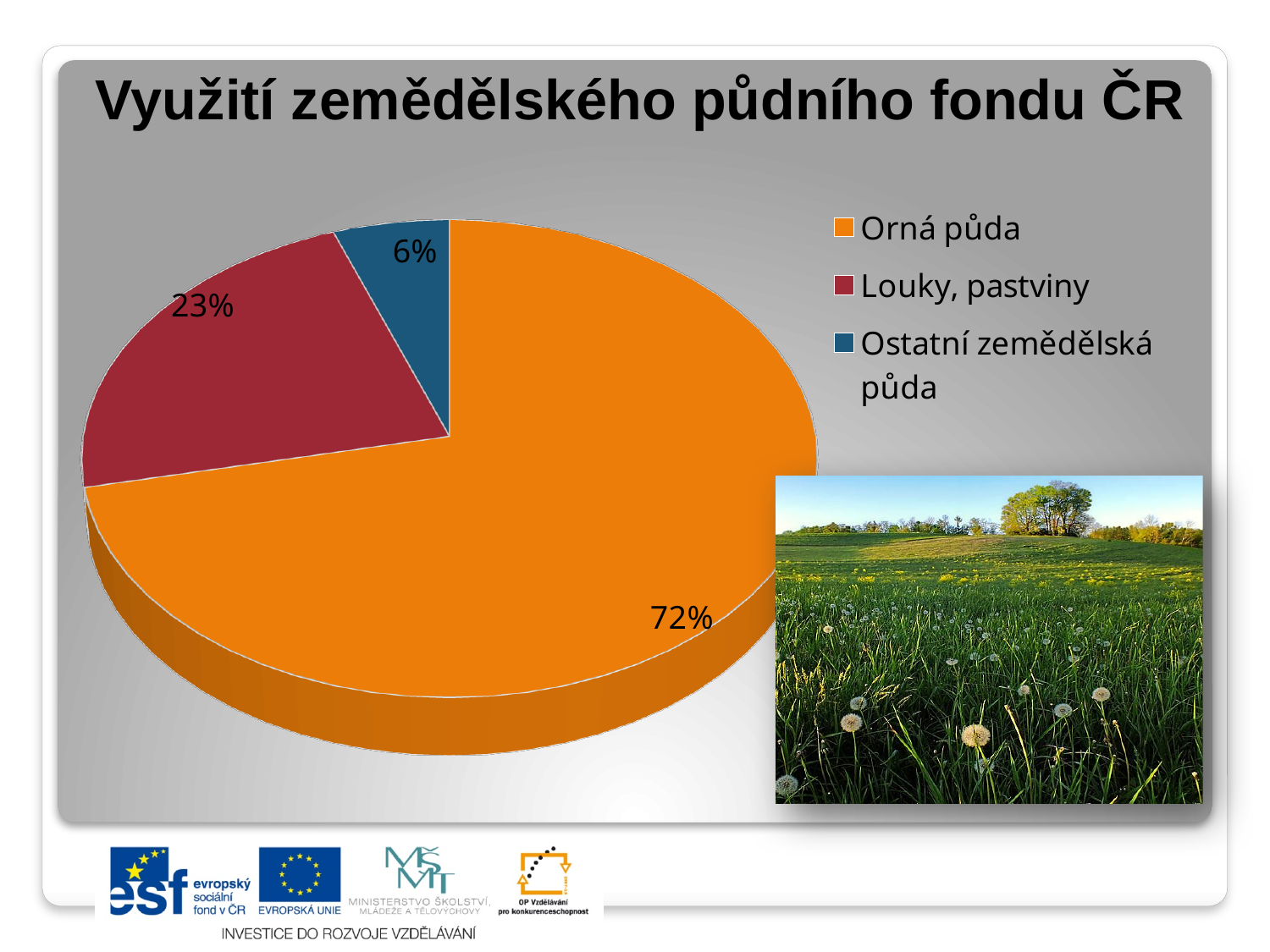
What share of the pie does Louky, pastviny represent? 23% What is the difference in percentage points between Louky, pastviny and Ostatní zemědělská půda? 17 Which category has the largest slice of the pie? Orná půda What share of the pie does Orná půda represent? 72% Which category has the smallest slice of the pie? Ostatní zemědělská půda How many categories are shown in the pie chart? 3 Which is larger, the share for Louky, pastviny or the share for Ostatní zemědělská půda? Louky, pastviny What is the title of the chart? Využití zemědělského půdního fondu ČR What is the difference in percentage points between Orná půda and Louky, pastviny? 49 What kind of chart is shown on the slide? pie chart What share of the pie does Ostatní zemědělská půda represent? 6% What colour is the slice for Orná půda? orange